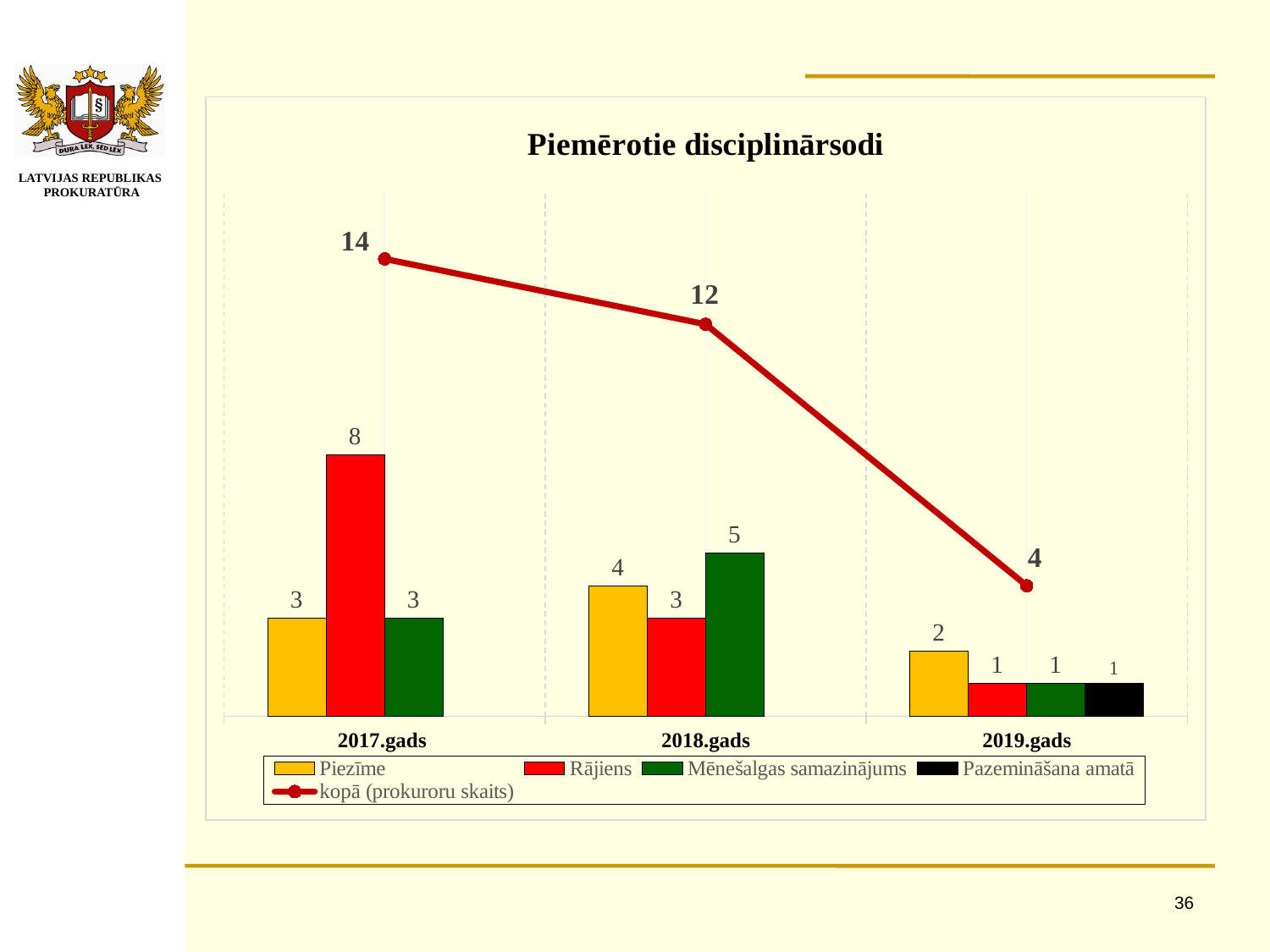
What is the value of Mēnešalgas samazinājums in 2018.gads? 5 What is the difference between kopā (prokuroru skaits) in 2017.gads and 2018.gads? 2 In which year is Piezīme lowest? 2019.gads How many series does the legend list? 5 What is the title of the chart? Piemērotie disciplinārsodi In which year is kopā (prokuroru skaits) highest? 2017.gads What is the value of kopā (prokuroru skaits) in 2019.gads? 4 Does kopā (prokuroru skaits) rise or fall from 2017.gads to 2019.gads? fall Which is larger in 2018.gads: Piezīme or Rājiens? Piezīme What is the value of Rājiens in 2017.gads? 8 What is the value of Piezīme in 2018.gads? 4 How many year categories are shown on the x axis? 3